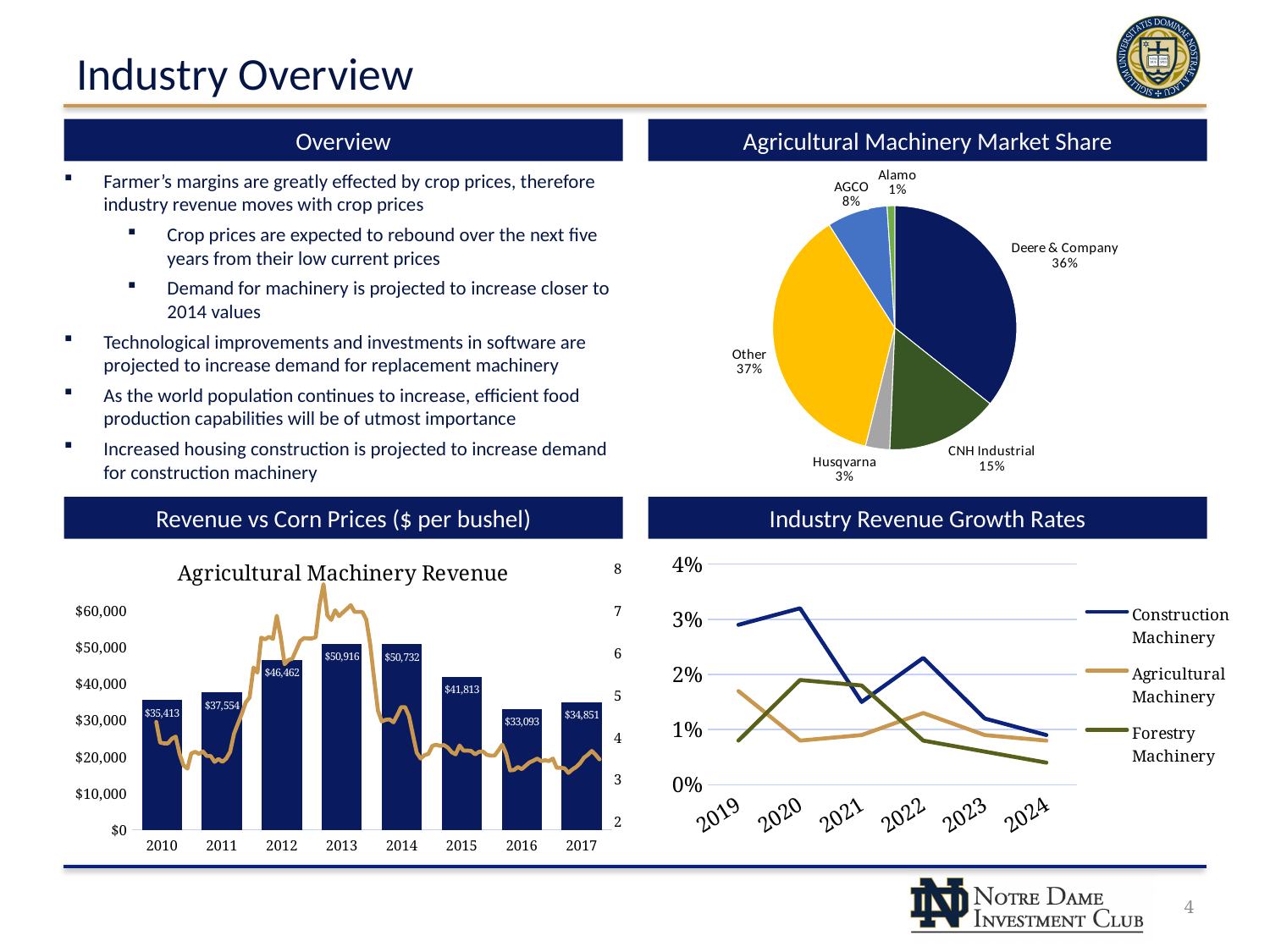
In the Agricultural Machinery Revenue chart, what is the revenue for 2013? $50,916 In the Agricultural Machinery Market Share pie chart, what share does Deere & Company hold? 36% In the Agricultural Machinery Revenue chart, is the revenue for 2015 larger than the revenue for 2017? Yes In the Industry Revenue Growth Rates chart, is the value for Construction Machinery in 2020 greater or less than 3%? greater In the Agricultural Machinery Revenue chart, how many years are shown on the x axis? 8 In the Agricultural Machinery Revenue chart, what is the difference between the 2012 and 2011 revenue values? $8,908 In the Industry Revenue Growth Rates chart, is the value for Forestry Machinery in 2024 greater or less than 1%? less In the Agricultural Machinery Market Share pie chart, which named company has the smallest share? Alamo In the Agricultural Machinery Revenue chart, which year has the lowest revenue? 2016 In the Industry Revenue Growth Rates chart, how many series does the legend list? 3 In the Agricultural Machinery Market Share pie chart, how many slices are there? 6 In the Agricultural Machinery Market Share pie chart, how much larger is CNH Industrial's share than AGCO's? 7%